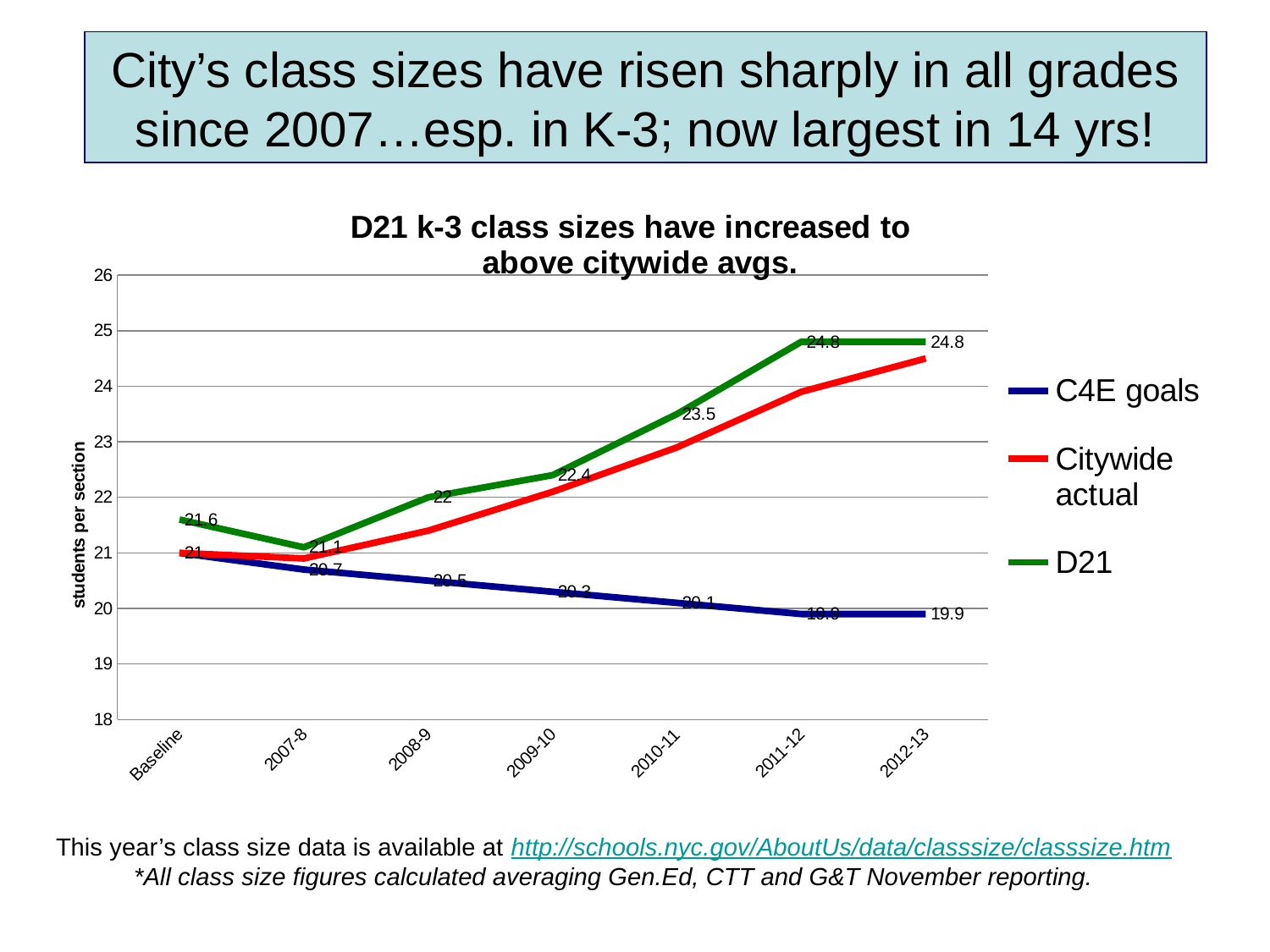
How many series does the legend list? 3 How many points are plotted along the x axis for each series? 7 What kind of chart is shown on the slide? line chart Do the C4E goals values rise or fall from Baseline to 2012-13? fall Which is larger in 2011-12, the D21 value or the C4E goals value? D21 What is the D21 value at Baseline? 21.6 What is the difference between the D21 value and the C4E goals value in 2012-13? 4.9 What is the D21 value for 2010-11? 23.5 Is the Citywide actual value for 2012-13 greater or less than 24? greater What is the C4E goals value for 2012-13? 19.9 What is the D21 value for 2012-13? 24.8 What is the label on the y axis? students per section